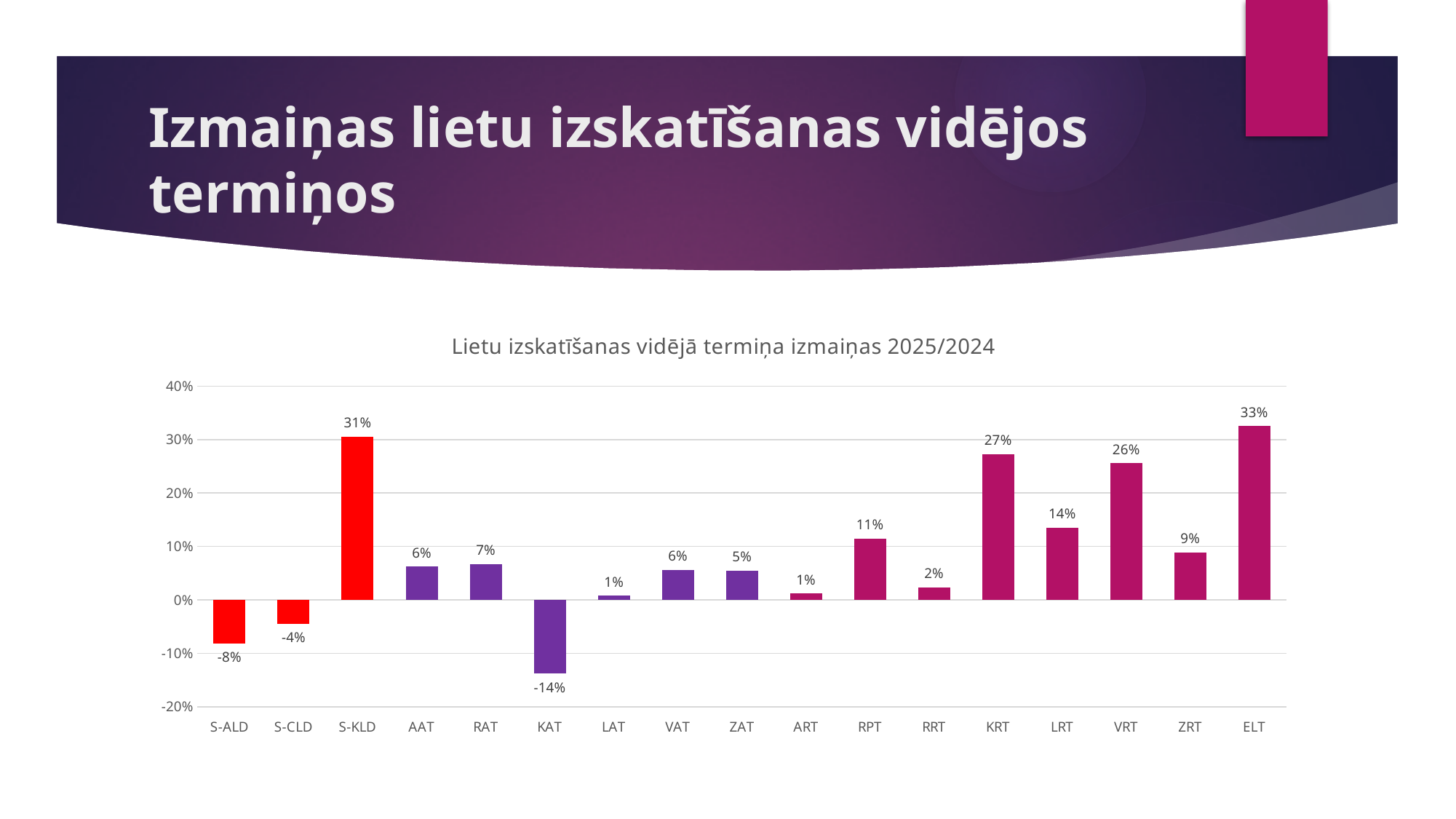
Which category has the lowest value? KAT Is the value for S-KLD greater or less than 20%? greater How many categories are shown on the x axis? 17 What is the value for VRT? 26% What is the difference between the values for ELT and KRT? 6% How many categories have a negative value? 3 Which category has the highest value? ELT Which is larger, the value for RPT or the value for LRT? LRT What is the value for S-KLD? 31% What kind of chart is shown on the slide? bar chart What is the value for KAT? -14% What is the title of the chart? Lietu izskatīšanas vidējā termiņa izmaiņas 2025/2024